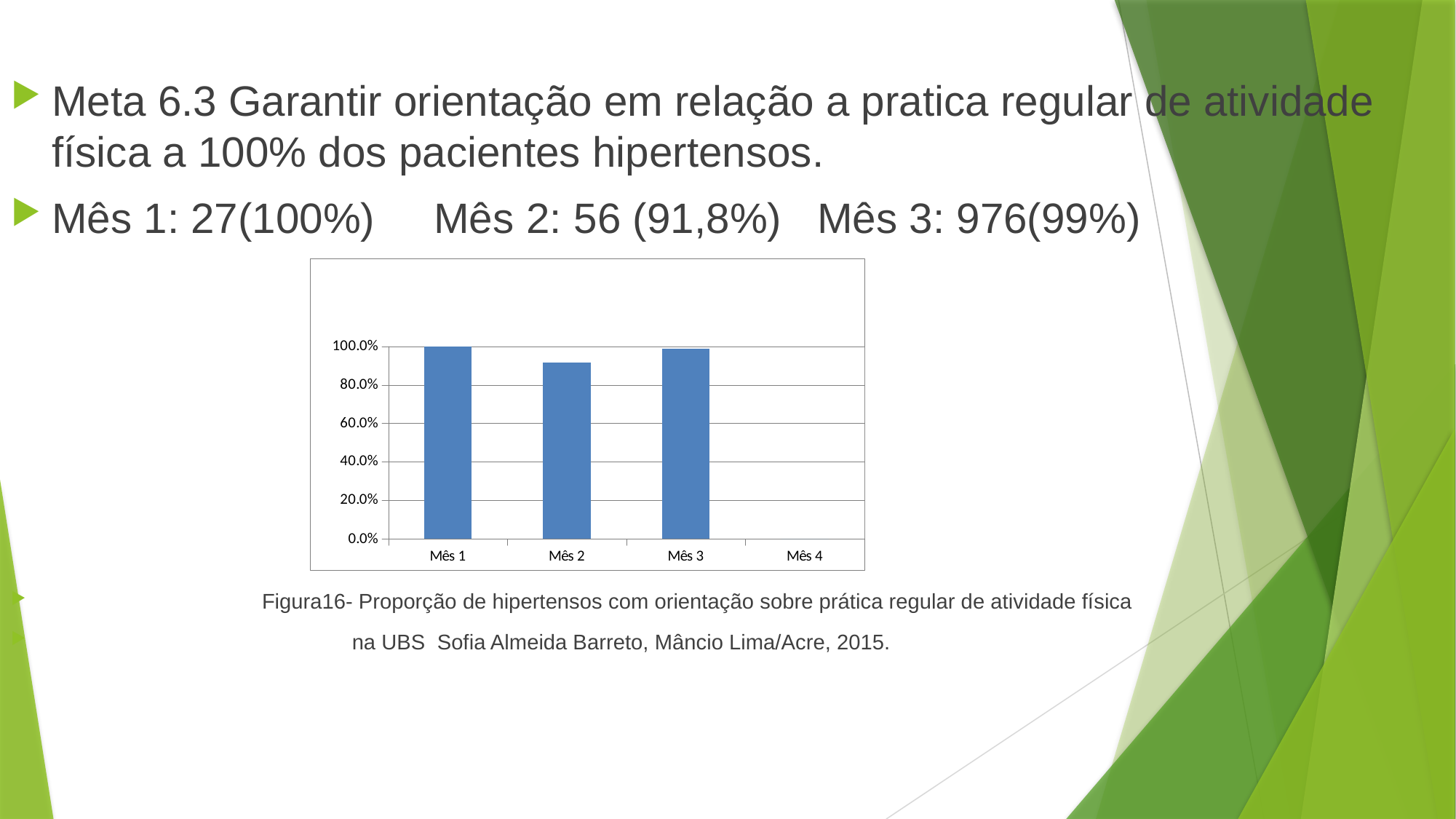
Which is larger, the value for Mês 1 or the value for Mês 2? Mês 1 What is the value for Mês 1 in the chart? 100.0% What colour are the bars in the chart? blue Which category on the x axis has no bar plotted? Mês 4 Is the value for Mês 2 greater or less than 100.0%? less Which is larger, the value for Mês 2 or the value for Mês 3? Mês 3 How many categories are shown on the x axis of the chart? 4 Which of the plotted months has the lowest value in the chart? Mês 2 What is the highest value shown on the y axis of the chart? 100.0% Is the value for Mês 2 greater or less than 80.0%? greater What kind of chart is shown on the slide? bar chart Is the value for Mês 3 greater or less than 80.0%? greater